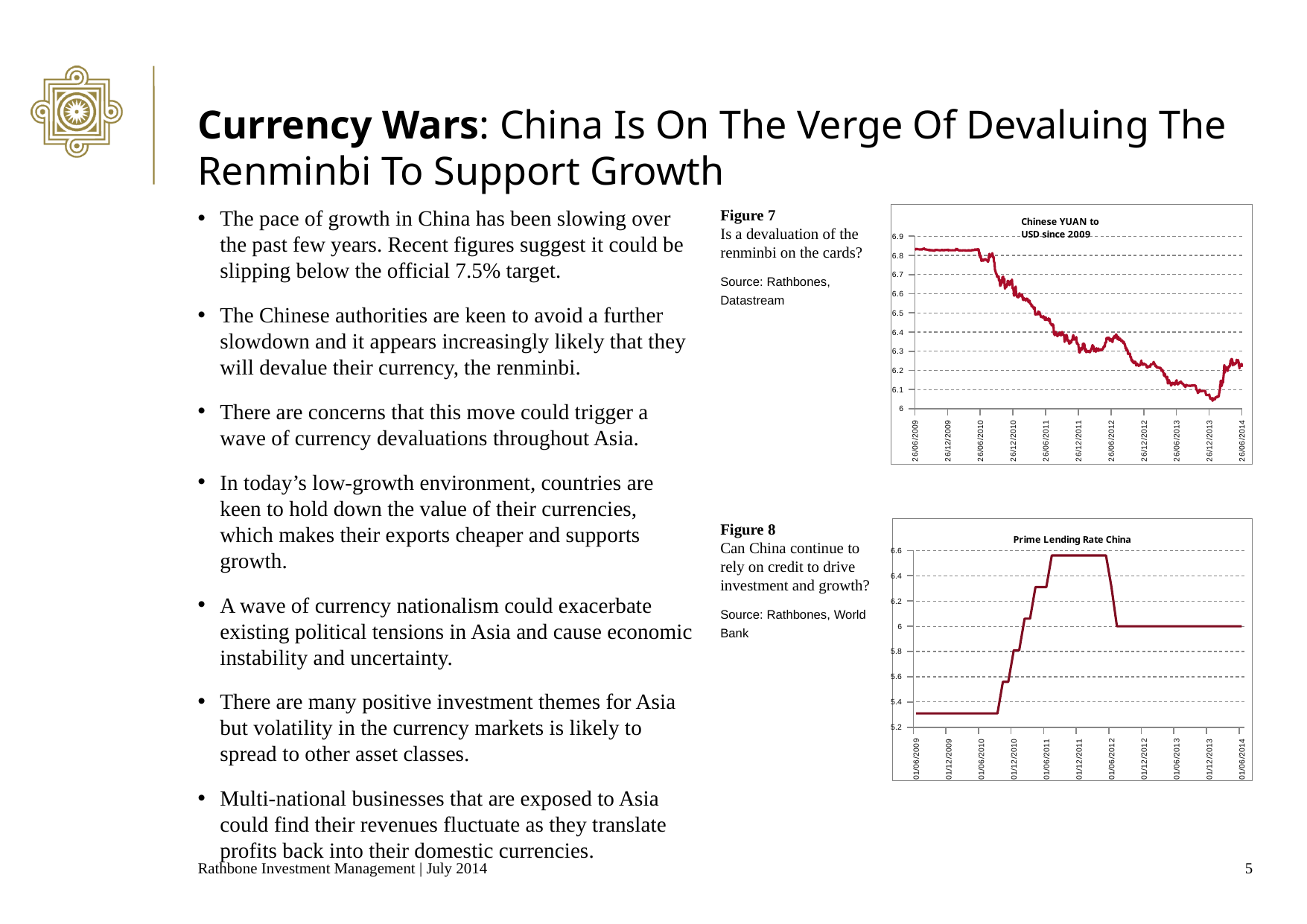
In the 'Prime Lending Rate China' chart, is the value at 01/12/2011 greater or less than 6.4? greater What kind of chart is the 'Chinese YUAN to USD since 2009' chart? line chart In the 'Prime Lending Rate China' chart, which is larger, the value at 01/12/2011 or the value at 01/06/2013? 01/12/2011 In the 'Chinese YUAN to USD since 2009' chart, do the values overall rise or fall from 26/06/2009 to 26/06/2014? fall In the 'Chinese YUAN to USD since 2009' chart, is the value at 26/12/2010 greater or less than 6.7? less What kind of chart is the 'Prime Lending Rate China' chart? line chart In the 'Prime Lending Rate China' chart, is the value at 01/06/2014 greater or less than 6.2? less In the 'Chinese YUAN to USD since 2009' chart, which is larger, the value at 26/06/2009 or the value at 26/06/2014? 26/06/2009 In the 'Prime Lending Rate China' chart, is the value at the end of the series (01/06/2014) higher or lower than at the start (01/06/2009)? higher What is the title of the chart labelled Figure 7? Chinese YUAN to USD since 2009